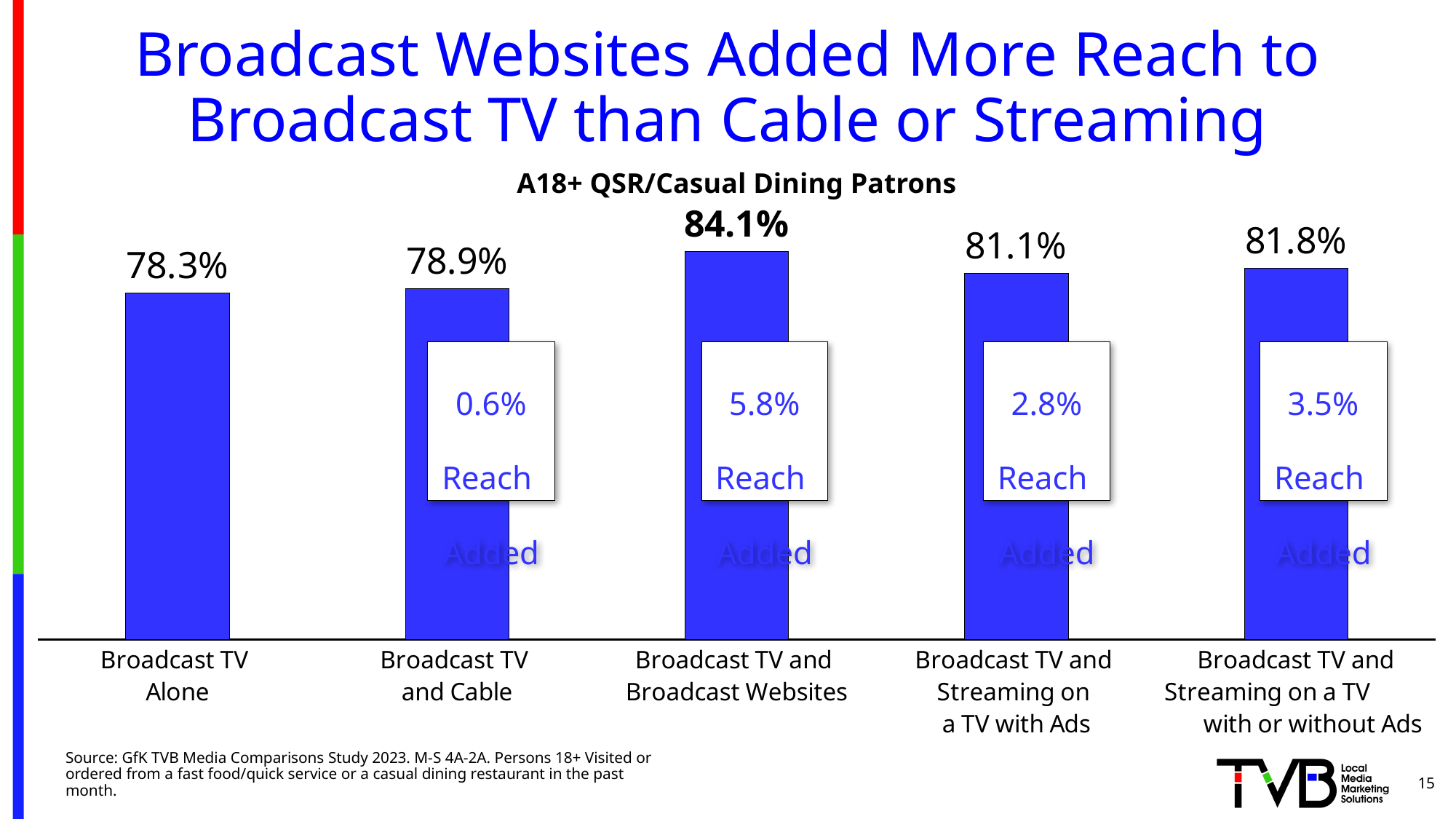
What is the reach value for Broadcast TV and Cable? 78.9% What is the reach value for Broadcast TV and Streaming on a TV with Ads? 81.1% What is the reach value for Broadcast TV Alone? 78.3% How much reach was added by Broadcast Websites according to the callout box? 5.8% What is the reach value for Broadcast TV and Broadcast Websites? 84.1% What kind of chart is shown on the slide? Bar chart What is the difference in reach between Broadcast TV and Broadcast Websites and Broadcast TV Alone? 5.8% What is the subtitle of the chart describing the audience? A18+ QSR/Casual Dining Patrons Which has a larger reach: Broadcast TV and Cable or Broadcast TV and Streaming on a TV with or without Ads? Broadcast TV and Streaming on a TV with or without Ads Which category has the highest reach? Broadcast TV and Broadcast Websites How many categories are shown in the chart? 5 Which category has the lowest reach? Broadcast TV Alone